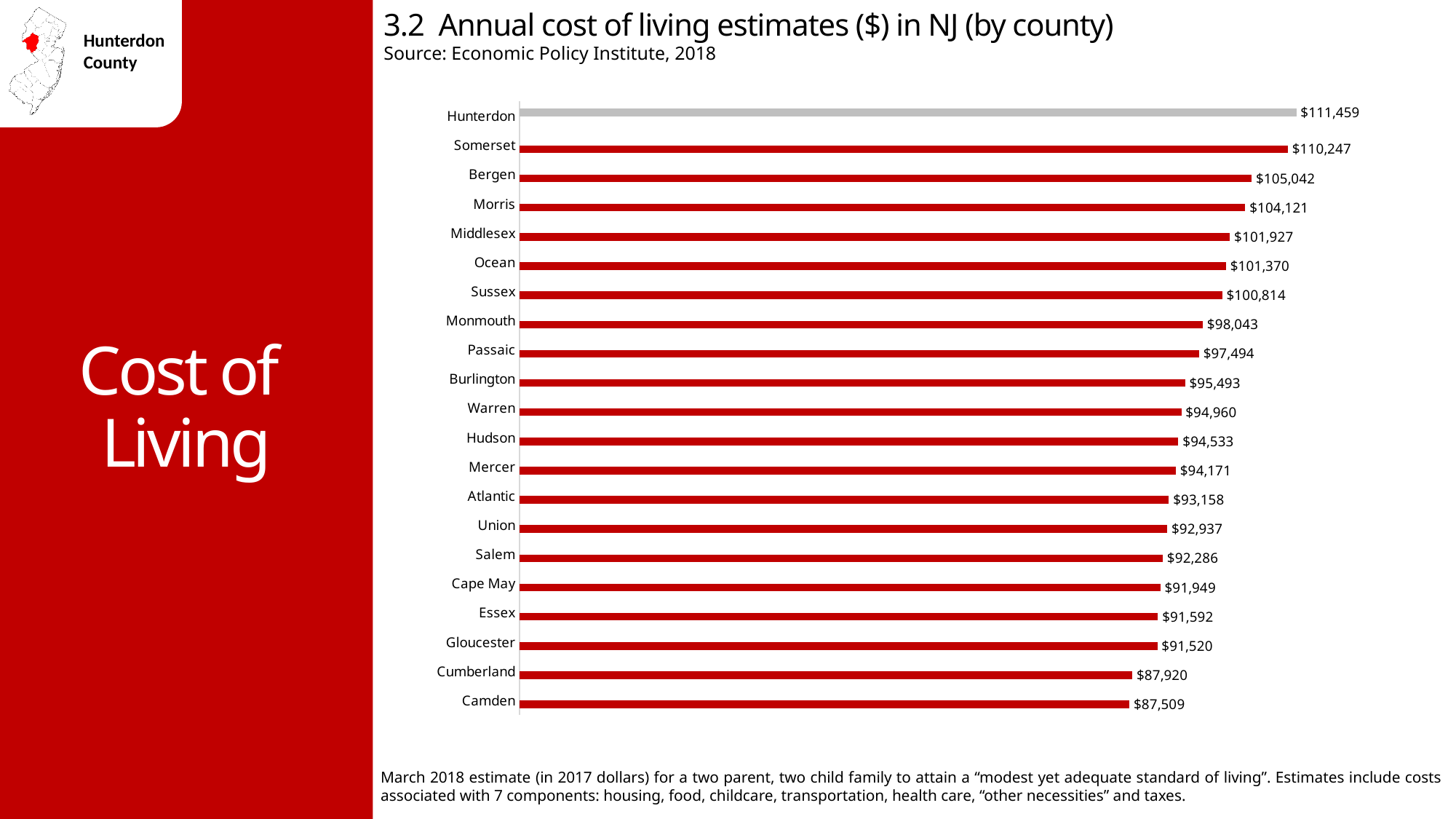
Which county has a higher cost of living estimate, Cumberland or Gloucester? Gloucester Which county has the highest annual cost of living estimate? Hunterdon What is the difference between the cost of living estimates for Hunterdon and Somerset counties? $1,212 Which county has a higher cost of living estimate, Ocean or Sussex? Ocean What kind of chart is used to show the annual cost of living estimates? Bar chart How many counties are shown in the chart? 21 Which county has the lowest annual cost of living estimate? Camden What is the difference between the cost of living estimates for Hunterdon and Camden counties? $23,950 What is the annual cost of living estimate for Hunterdon County? $111,459 What is the annual cost of living estimate for Cape May County? $91,949 Which county's bar is shown in a different colour (grey) from the others? Hunterdon What is the annual cost of living estimate for Morris County? $104,121